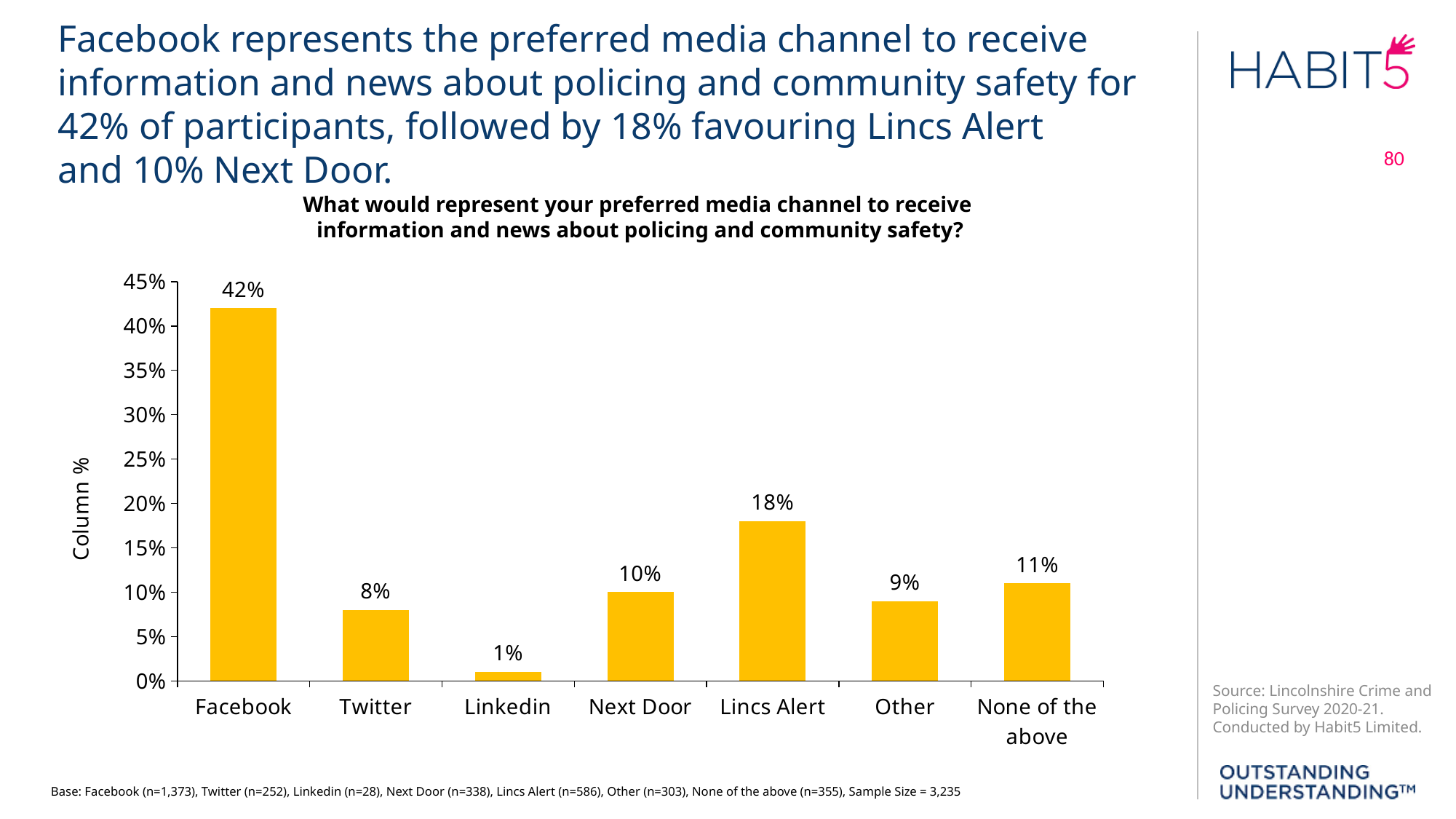
What is the difference between the values for Next Door and Twitter? 2% Which media channel has the lowest percentage? Linkedin What is the label on the vertical axis of the chart? Column % What is the difference between the values for Facebook and Lincs Alert? 24% What is the value shown for None of the above? 11% What percentage of participants chose Facebook as their preferred media channel? 42% Which is larger, the value for Other or the value for None of the above? None of the above How many media channel categories are shown on the x axis? 7 What kind of chart is shown on the slide? Bar chart Which media channel has the highest percentage? Facebook Is the value for Lincs Alert greater or less than 15%? greater What is the value shown for Lincs Alert? 18%